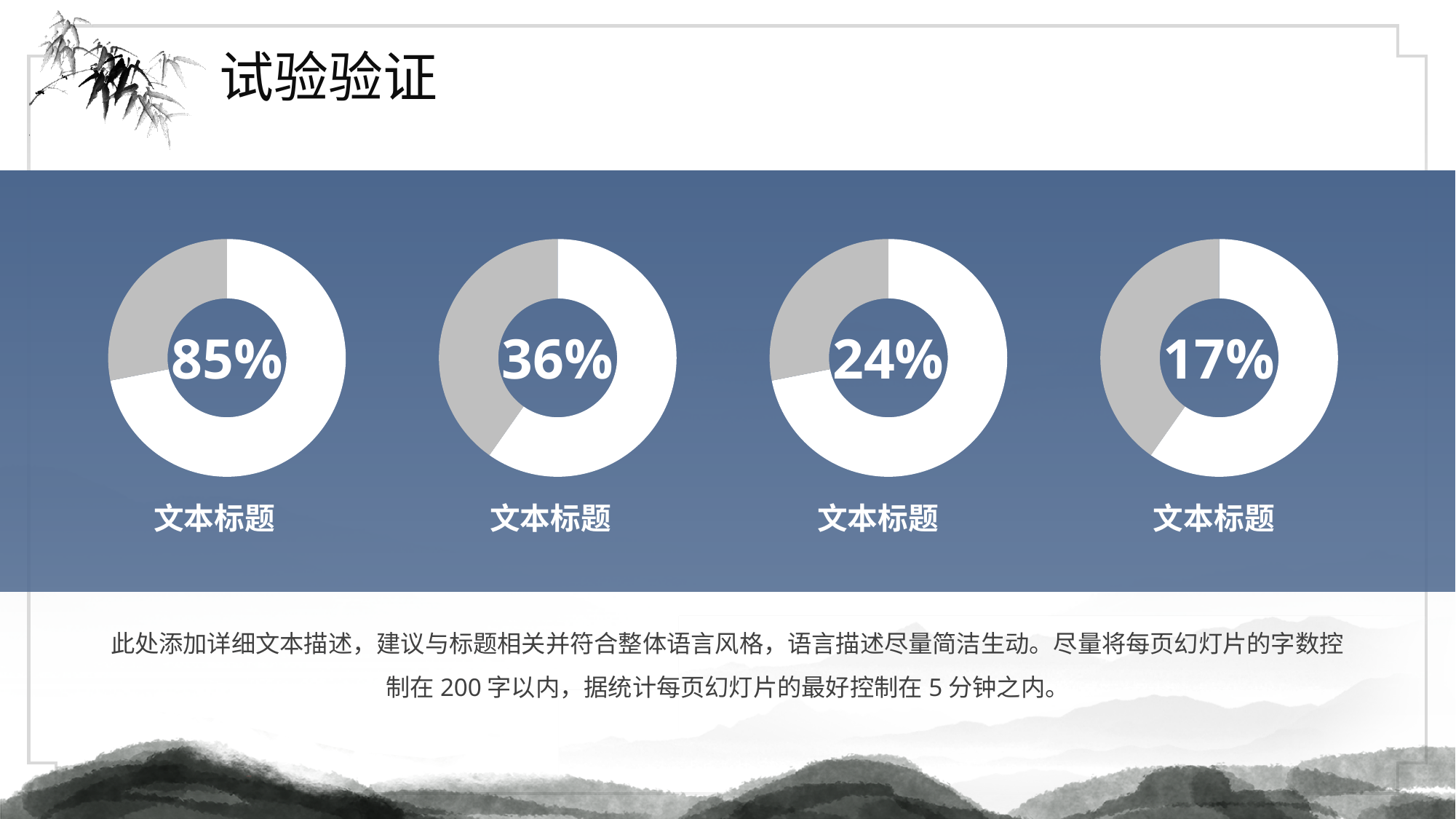
What is the difference between the percentages shown in the second and third donut charts from the left? 12% What is the difference between the percentage in the leftmost donut chart and the percentage in the rightmost donut chart? 68% Which of the four donut charts shows the lowest percentage? The rightmost chart (17%) Which of the four donut charts shows the highest percentage? The leftmost chart (85%) What label text appears beneath each of the four donut charts? 文本标题 What kind of chart is used to display the percentages on this slide? Donut chart What percentage is shown in the centre of the rightmost donut chart? 17% How many donut charts are on the slide? 4 What percentage is shown in the centre of the leftmost donut chart? 85% What percentage is shown in the centre of the third donut chart from the left? 24% Which shows a larger percentage, the second donut chart from the left or the third donut chart from the left? The second chart from the left (36%) What percentage is shown in the centre of the second donut chart from the left? 36%